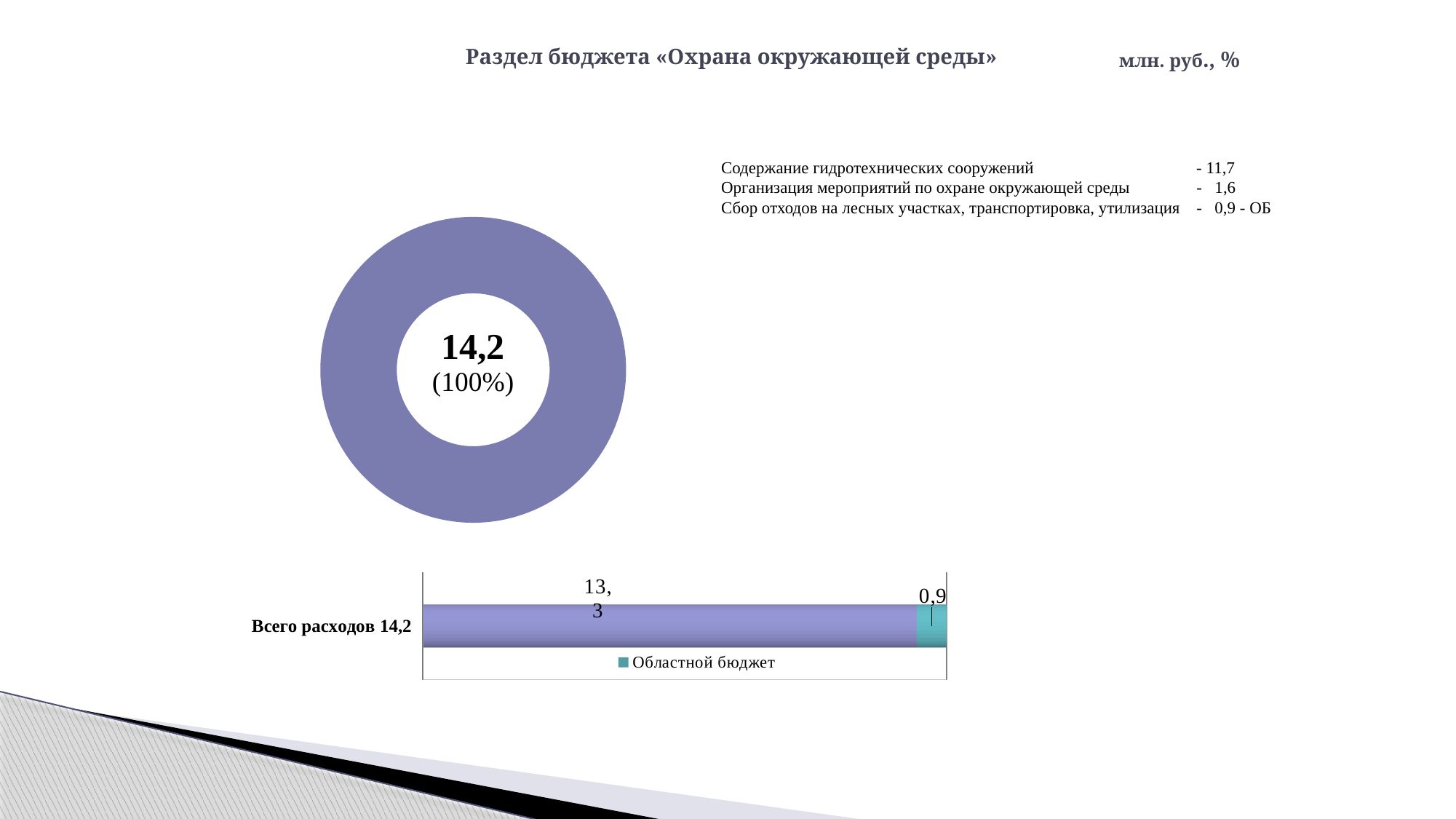
What kind of chart is the chart at the bottom of the slide? bar chart What is the title of the slide above the charts? Раздел бюджета «Охрана окружающей среды» In the bottom bar chart, what is the value of the smaller (teal) segment of the bar? 0,9 In the bottom bar chart, what is the total of the stacked bar labelled 'Всего расходов'? 14,2 In the bottom bar chart, what legend entry is shown? Областной бюджет In the bottom bar chart, what is the difference between the two segments, 13,3 and 0,9? 12,4 In the doughnut chart, what value is printed in the centre? 14,2 In the bottom bar chart, how many bars (categories) are plotted? 1 What kind of chart is the chart on the left of the slide? doughnut chart In the bottom bar chart, what is the value of the larger (purple) segment of the bar? 13,3 In the doughnut chart, what share of the whole does the single slice represent? 100% In the bottom bar chart, which segment is larger, the purple one or the teal one? the purple one (13,3)